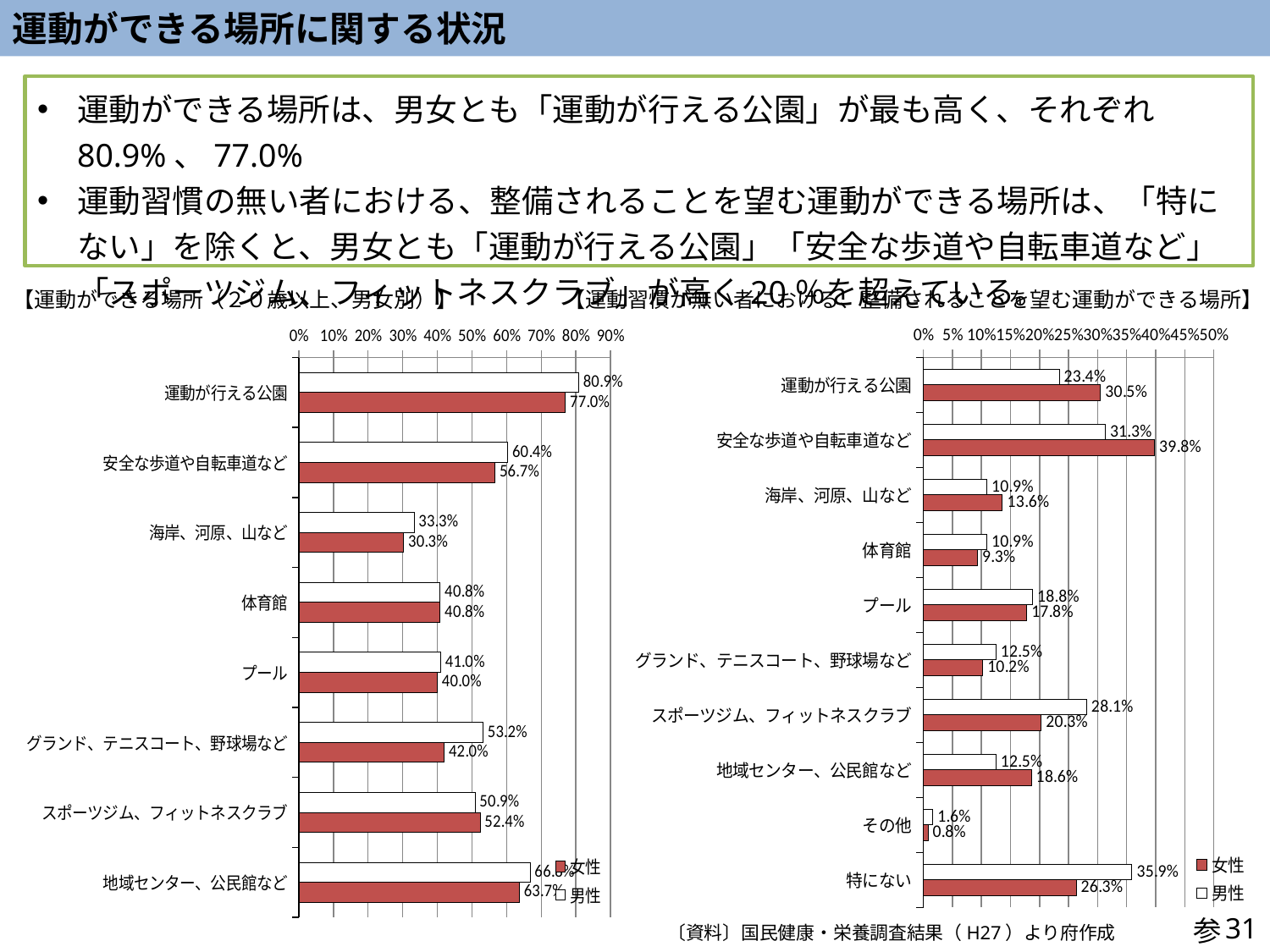
In the right chart (整備されることを望む運動ができる場所), what is the difference between 女性 and 男性 for 運動が行える公園? 7.1% In the right chart (整備されることを望む運動ができる場所), what is the value for 女性 for 安全な歩道や自転車道など? 39.8% In the left chart (運動ができる場所), how many categories are shown? 8 What type of chart is the right chart (整備されることを望む運動ができる場所)? Bar chart In the right chart (整備されることを望む運動ができる場所), which category has the highest value for 男性? 特にない In the left chart (運動ができる場所), what is the value for 女性 for 安全な歩道や自転車道など? 56.7% In the left chart (運動ができる場所), which category has the highest value for 女性? 運動が行える公園 In the left chart (運動ができる場所), which category has the lowest value for 男性? 海岸、河原、山など In the right chart (整備されることを望む運動ができる場所), how many categories are shown? 10 In the right chart (整備されることを望む運動ができる場所), which is larger for スポーツジム、フィットネスクラブ, 男性 or 女性? 男性 In the left chart (運動ができる場所), what is the value for 男性 for 運動が行える公園? 80.9% In the left chart (運動ができる場所), what is the difference between 男性 and 女性 for グランド、テニスコート、野球場など? 11.2%